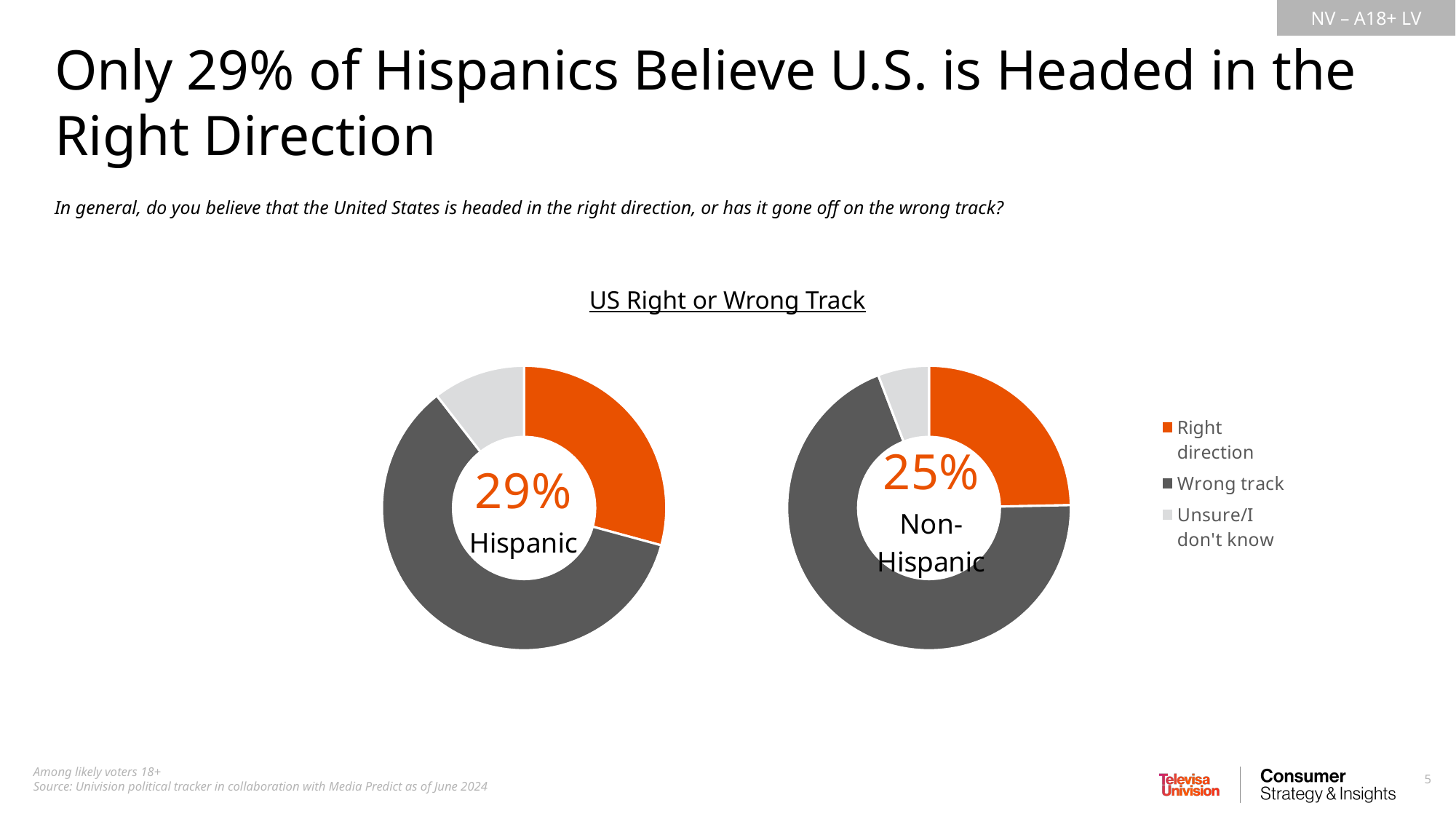
Which colour represents 'Wrong track' in the charts? Dark grey Which group has the larger share saying 'Right direction', Hispanic or Non-Hispanic? Hispanic What is the difference in percentage points between the Hispanic and Non-Hispanic 'Right direction' shares? 4 percentage points In the Hispanic chart, which response is the smallest slice? Unsure/I don't know How many response categories does the legend list? 3 What kind of chart is used to show the US Right or Wrong Track results? Pie (donut) chart In the Hispanic chart, what percentage say the U.S. is headed in the right direction? 29% In the Non-Hispanic chart, which response is the smallest slice? Unsure/I don't know What is the title shown above the two charts? US Right or Wrong Track How many donut charts are shown on the slide? 2 In the Hispanic chart, which response is the largest slice? Wrong track In the Non-Hispanic chart, what percentage say the U.S. is headed in the right direction? 25%